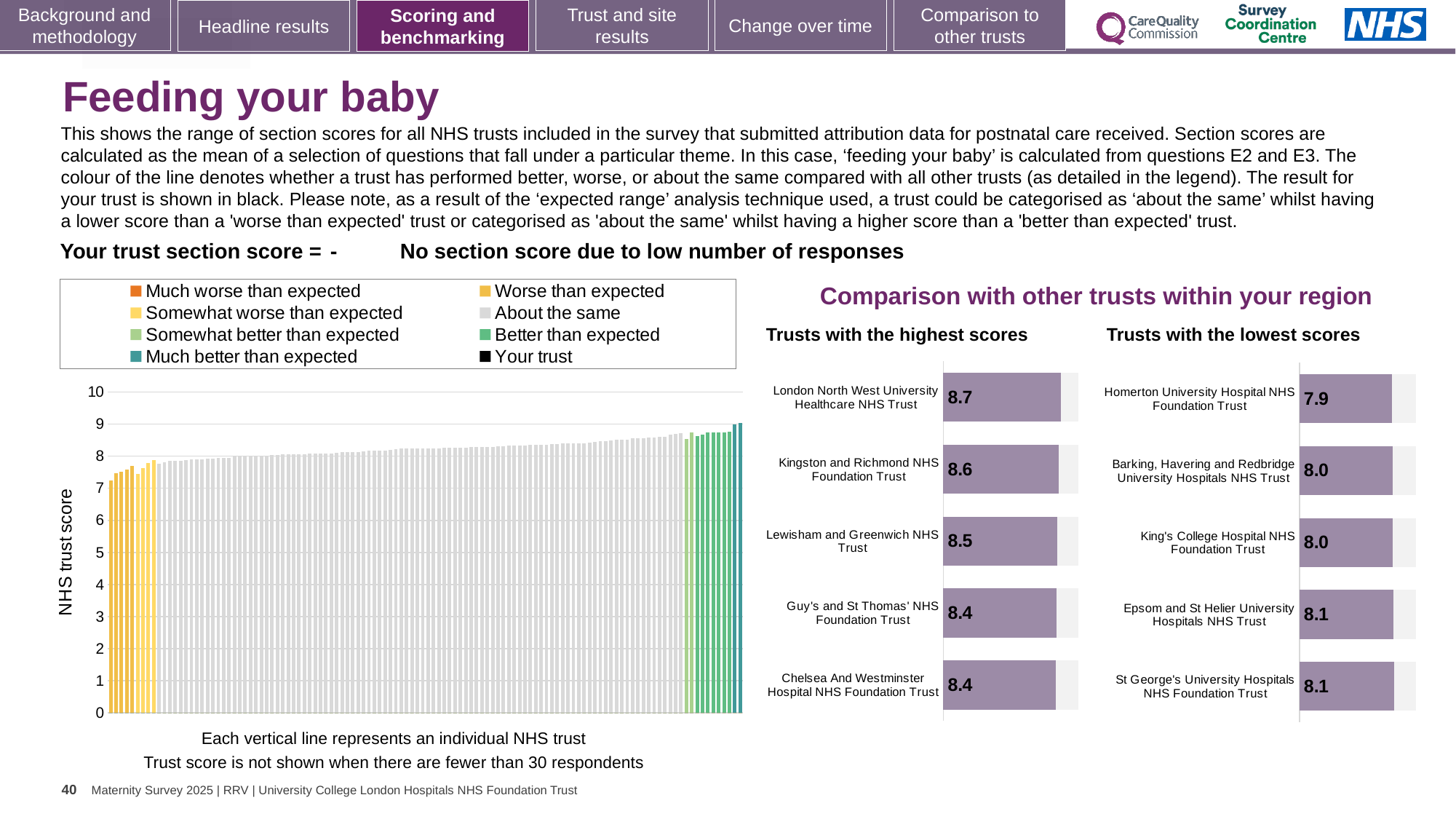
In the 'Trusts with the highest scores' chart, what is the score for London North West University Healthcare NHS Trust? 8.7 How many trusts are shown in the 'Trusts with the lowest scores' chart? 5 What kind of chart is the large chart on the left with the 'NHS trust score' axis? Bar chart In the 'Trusts with the highest scores' chart, which trust has the highest score? London North West University Healthcare NHS Trust In the 'Trusts with the highest scores' chart, what is the score for Lewisham and Greenwich NHS Trust? 8.5 How many entries does the legend above the large 'NHS trust score' chart list? 8 In the 'Trusts with the lowest scores' chart, which has the larger score: Homerton University Hospital NHS Foundation Trust or Epsom and St Helier University Hospitals NHS Trust? Epsom and St Helier University Hospitals NHS Trust In the 'Trusts with the lowest scores' chart, what is the score for Epsom and St Helier University Hospitals NHS Trust? 8.1 In the large 'NHS trust score' chart on the left, do the bar values rise or fall from left to right? Rise In the 'Trusts with the highest scores' chart, what is the difference between the scores of London North West University Healthcare NHS Trust and Lewisham and Greenwich NHS Trust? 0.2 In the 'Trusts with the lowest scores' chart, which trust has the lowest score? Homerton University Hospital NHS Foundation Trust In the 'Trusts with the lowest scores' chart, what is the score for Homerton University Hospital NHS Foundation Trust? 7.9